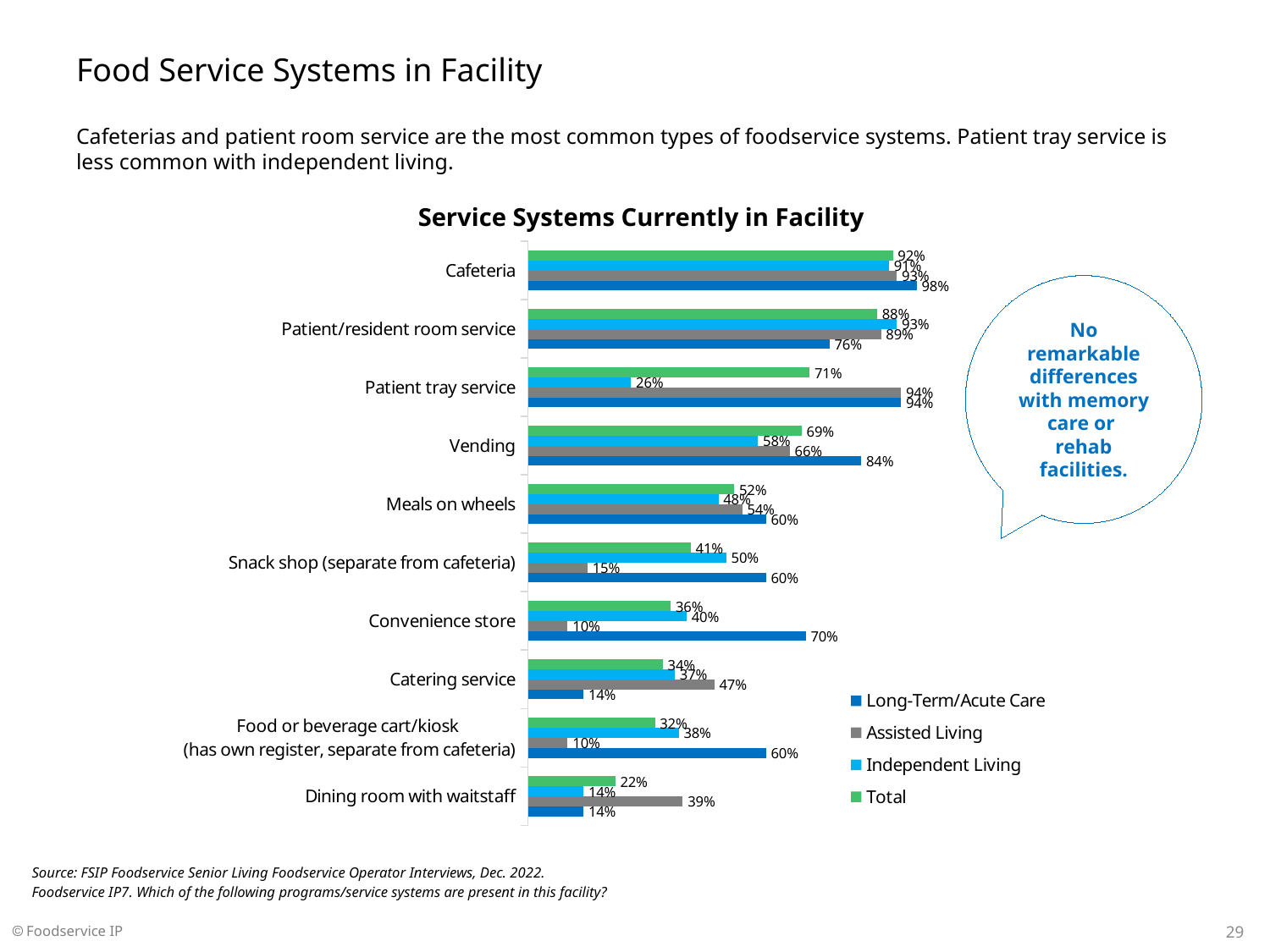
What is the Total value for Dining room with waitstaff? 22% What is the title of the chart? Service Systems Currently in Facility What is the Assisted Living value for Convenience store? 10% What is the Independent Living value for Patient tray service? 26% What kind of chart is shown on the slide? Bar chart Which category has the lowest Long-Term/Acute Care value? Catering service and Dining room with waitstaff (both 14%) What is the Long-Term/Acute Care value for Cafeteria? 98% What is the difference between the Assisted Living and Independent Living values for Patient tray service? 68% Which category has the highest Total value? Cafeteria How many service system categories are shown on the chart? 10 How many series does the legend list? 4 For Catering service, which is larger: the Assisted Living value or the Long-Term/Acute Care value? Assisted Living